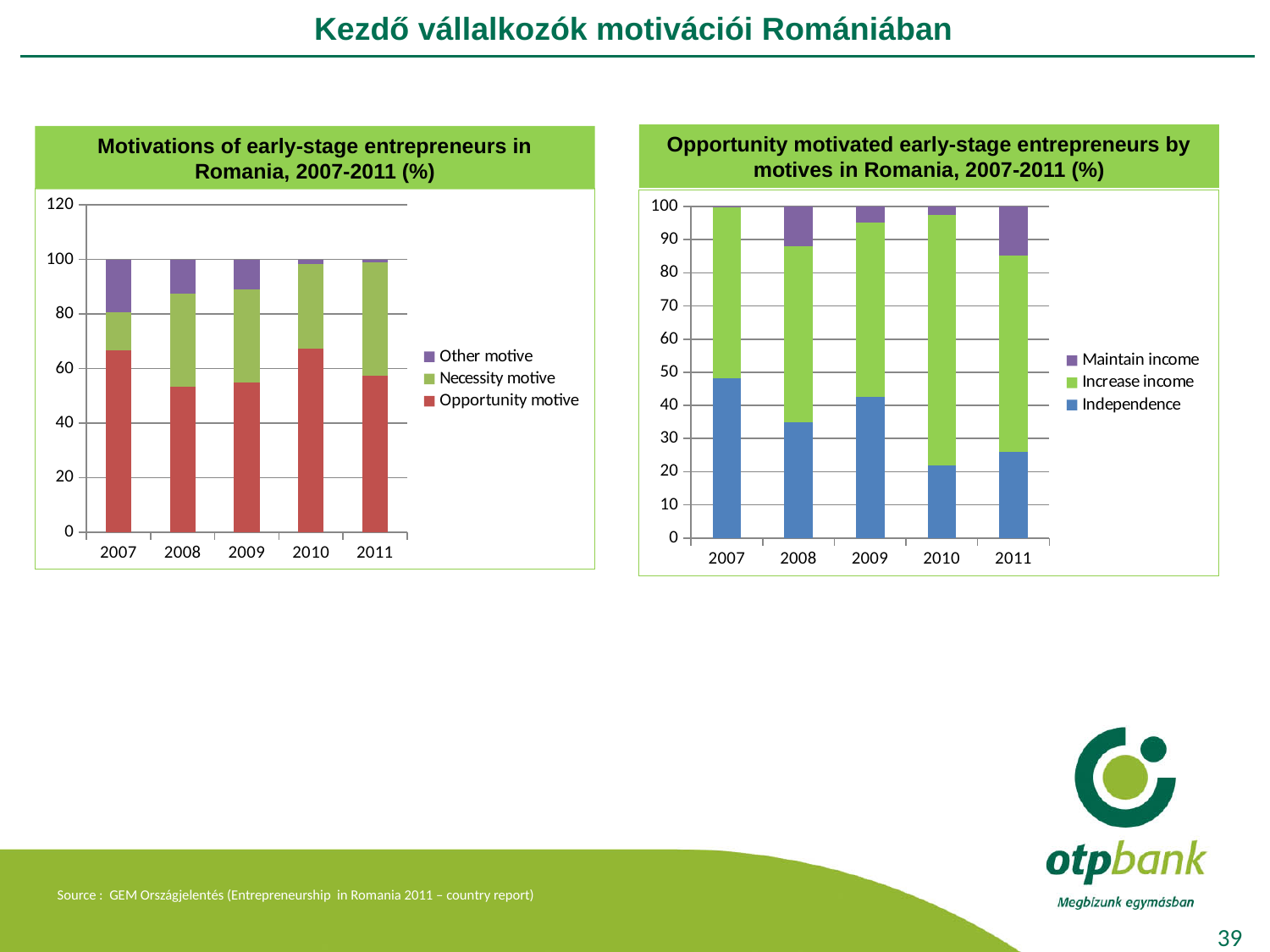
In the right chart, 'Opportunity motivated early-stage entrepreneurs by motives in Romania, 2007-2011 (%)', is the value for Independence in 2007 greater or less than 40? greater In the right chart, 'Opportunity motivated early-stage entrepreneurs by motives in Romania, 2007-2011 (%)', is the value for Independence in 2010 greater or less than 30? less In the right chart, 'Opportunity motivated early-stage entrepreneurs by motives in Romania, 2007-2011 (%)', which year has the lowest value for Independence? 2010 How many years are shown on the x axis of the left chart, 'Motivations of early-stage entrepreneurs in Romania, 2007-2011 (%)'? 5 What kind of chart is the left chart, 'Motivations of early-stage entrepreneurs in Romania, 2007-2011 (%)'? Stacked bar chart In the left chart, 'Motivations of early-stage entrepreneurs in Romania, 2007-2011 (%)', is the value for Opportunity motive in 2008 greater or less than 60? less In the right chart, 'Opportunity motivated early-stage entrepreneurs by motives in Romania, 2007-2011 (%)', which year has the highest value for Independence? 2007 How many series does the legend of the right chart, 'Opportunity motivated early-stage entrepreneurs by motives in Romania, 2007-2011 (%)', list? 3 In the left chart, 'Motivations of early-stage entrepreneurs in Romania, 2007-2011 (%)', which legend entry is shown in purple? Other motive In the right chart, 'Opportunity motivated early-stage entrepreneurs by motives in Romania, 2007-2011 (%)', does the Independence value rise or fall from 2007 to 2010? fall In the right chart, 'Opportunity motivated early-stage entrepreneurs by motives in Romania, 2007-2011 (%)', is the Independence value larger in 2007 or in 2010? 2007